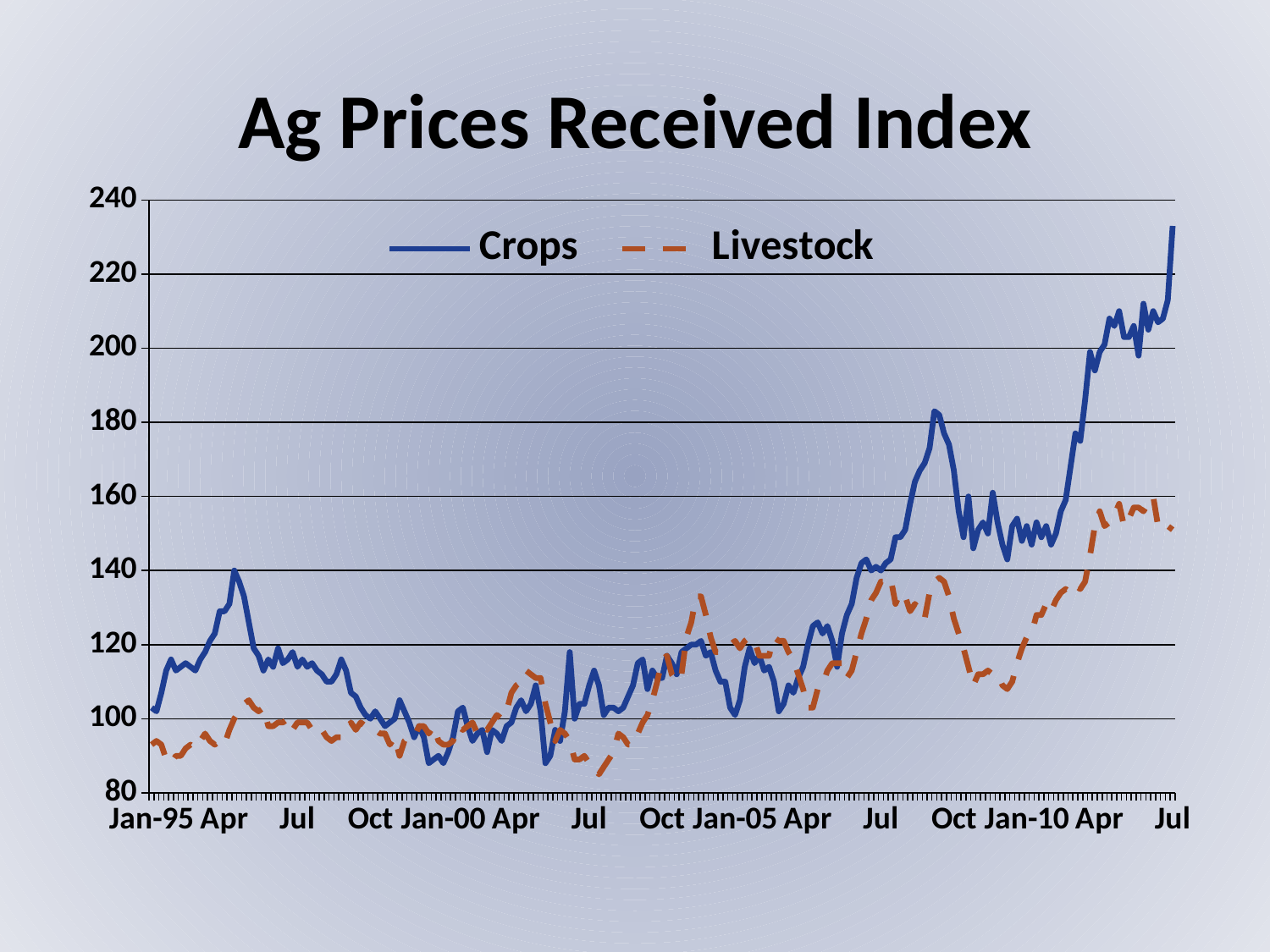
Is the value for Livestock at Jan-95 greater or less than 100? less What is the title of the chart? Ag Prices Received Index What kind of chart is shown on the slide? line chart Is the value for Crops at Jan-95 greater or less than 120? less At the final point (Jul), which series has the higher value, Crops or Livestock? Crops Is the highest value reached by Livestock greater or less than 140? greater Overall, does the Crops series rise or fall from Jan-95 to the final Jul? rise Which series reaches the highest value anywhere on the chart? Crops How many series does the legend list? 2 Which series is drawn with a dashed line? Livestock